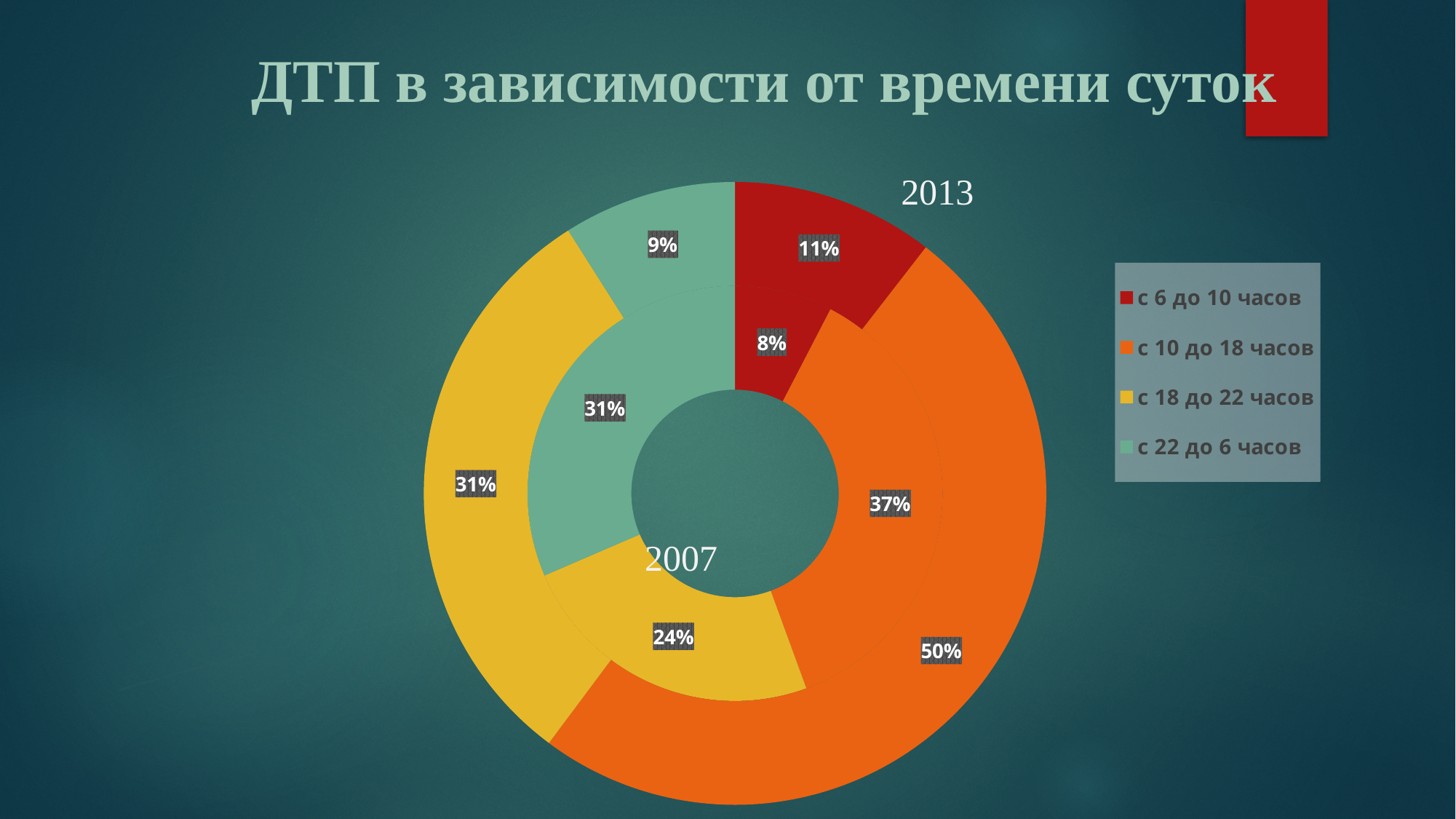
What is the difference between the 'с 10 до 18 часов' share in 2013 and in 2007? 13% How many time periods does the legend list? 4 What is the share of accidents for 'с 18 до 22 часов' in the 2007 ring? 24% What is the title of the chart? ДТП в зависимости от времени суток Which is larger: the 'с 22 до 6 часов' share in 2007 or in 2013? 2007 What is the share of accidents for 'с 6 до 10 часов' in the 2007 ring? 8% Which time period has the largest share in the 2013 ring? с 10 до 18 часов What is the share of accidents for 'с 10 до 18 часов' in the 2013 ring? 50% What is the share of accidents for 'с 22 до 6 часов' in the 2013 ring? 9% Which time period has the smallest share in the 2007 ring? с 6 до 10 часов How many years (rings) are shown in the chart? 2 What type of chart is shown on the slide? doughnut chart